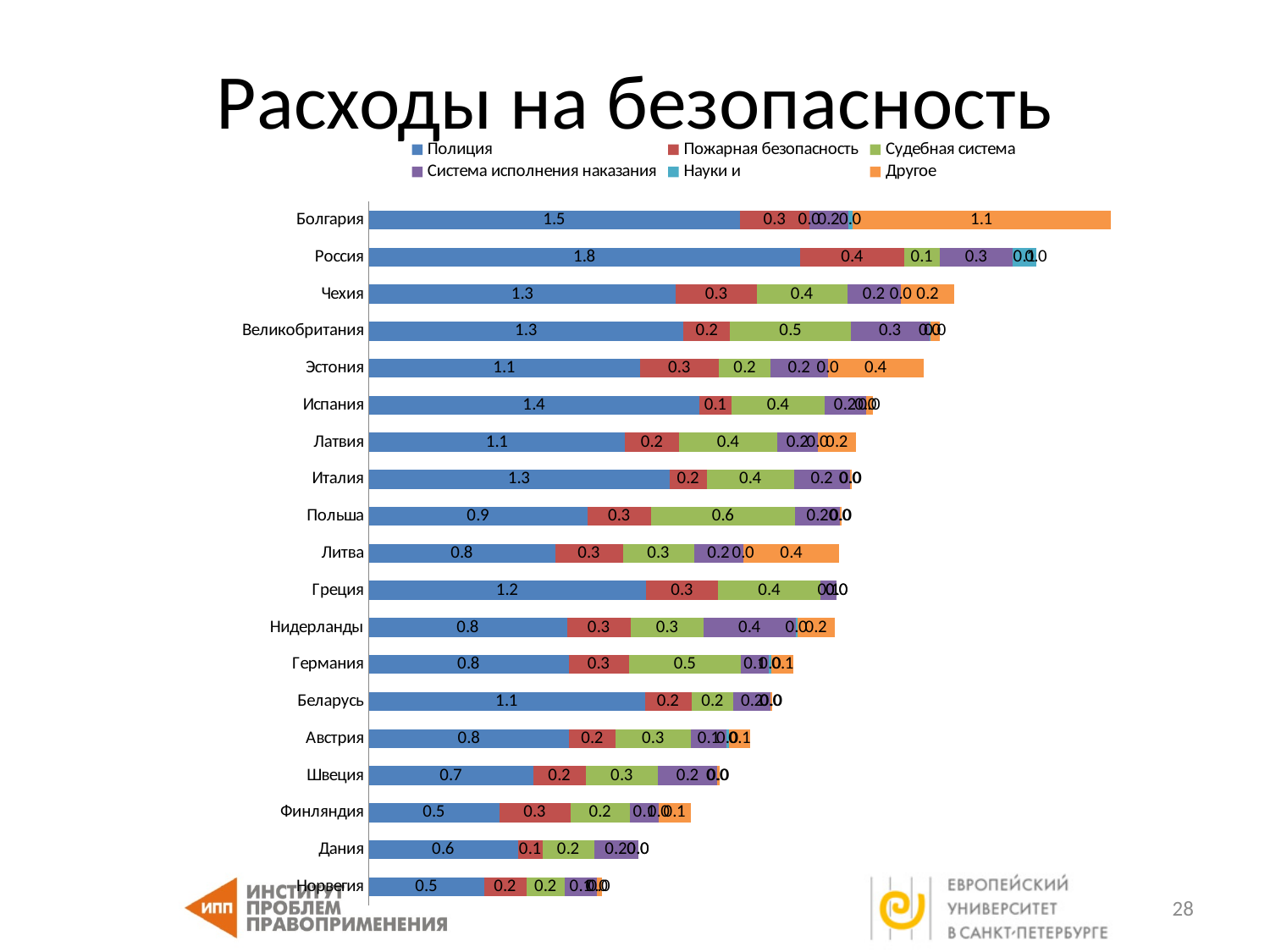
How many countries are shown in the chart? 19 What kind of chart is shown on the slide? bar chart Which has the larger Судебная система value, Великобритания or Чехия? Великобритания What is the value of Другое for Болгария? 1.1 How many series does the legend list? 6 What is the title of the chart? Расходы на безопасность What is the total of the stacked bar for Эстония? 2.2 What is the value of Судебная система for Польша? 0.6 What is the value of Полиция for Россия? 1.8 What is the value of Система исполнения наказания for Нидерланды? 0.4 Which country has the highest value for Полиция? Россия What is the difference between the Полиция values for Россия and Болгария? 0.3